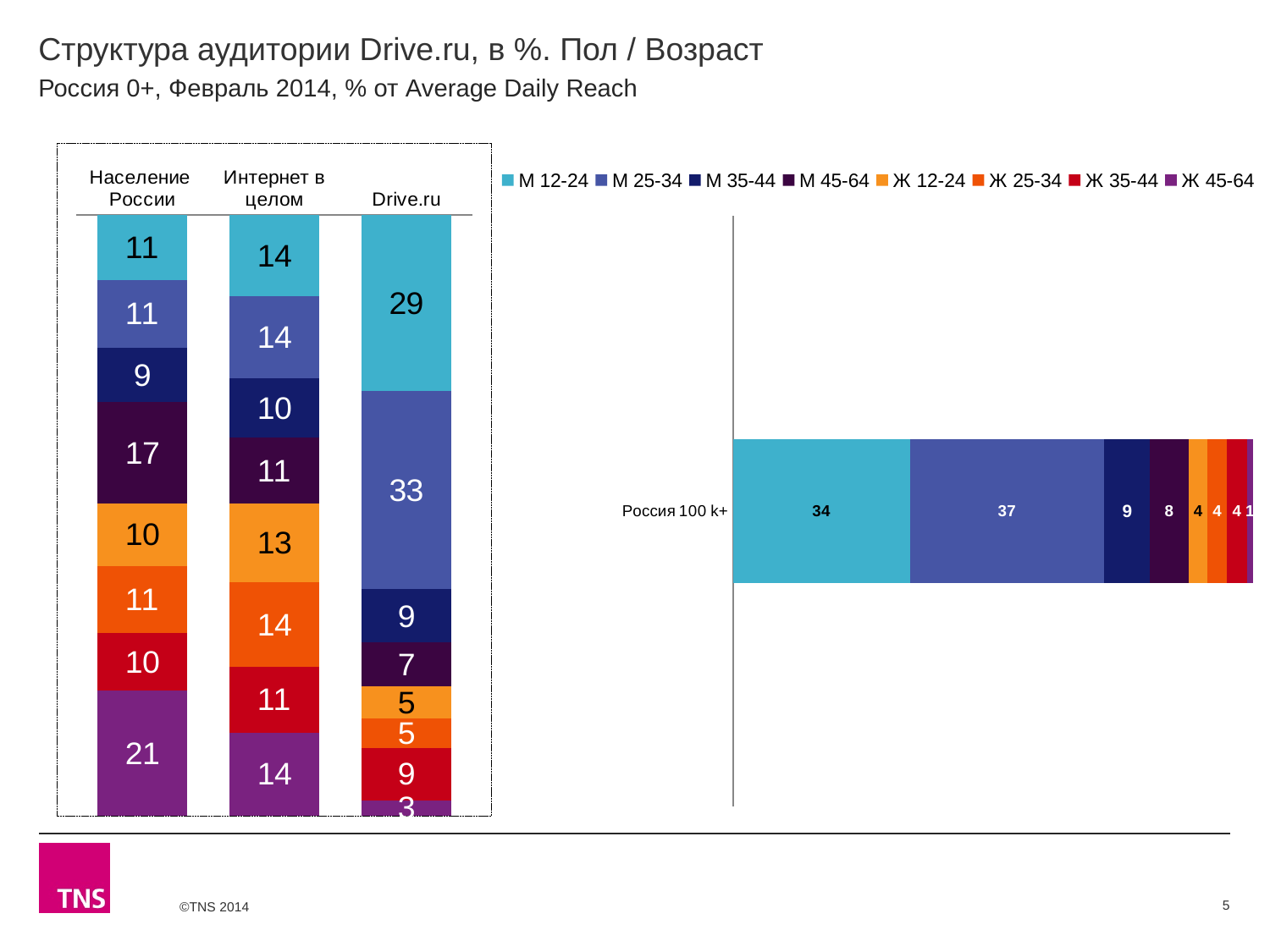
In the left chart, which segment is the smallest in the Drive.ru bar? Ж 45-64 In the left chart, what is the total of the Население России bar? 100 In the left chart, which segment is the largest in the Drive.ru bar? М 25-34 How many series does the legend list? 8 In the right chart (Россия 100 k+), which segment is the smallest? Ж 45-64 In the left chart, what is the difference between the М 12-24 values for Drive.ru and Интернет в целом? 15 In the left chart, what is the value for Ж 45-64 in the Население России bar? 21 In the right chart (Россия 100 k+), what is the value for М 25-34? 37 What kind of chart is the right chart (Россия 100 k+)? Stacked bar chart How many bars does the left chart show? 3 In the left chart, what is the value for М 12-24 in the Drive.ru bar? 29 In the left chart, which is larger: the М 45-64 value for Население России or for Drive.ru? Население России